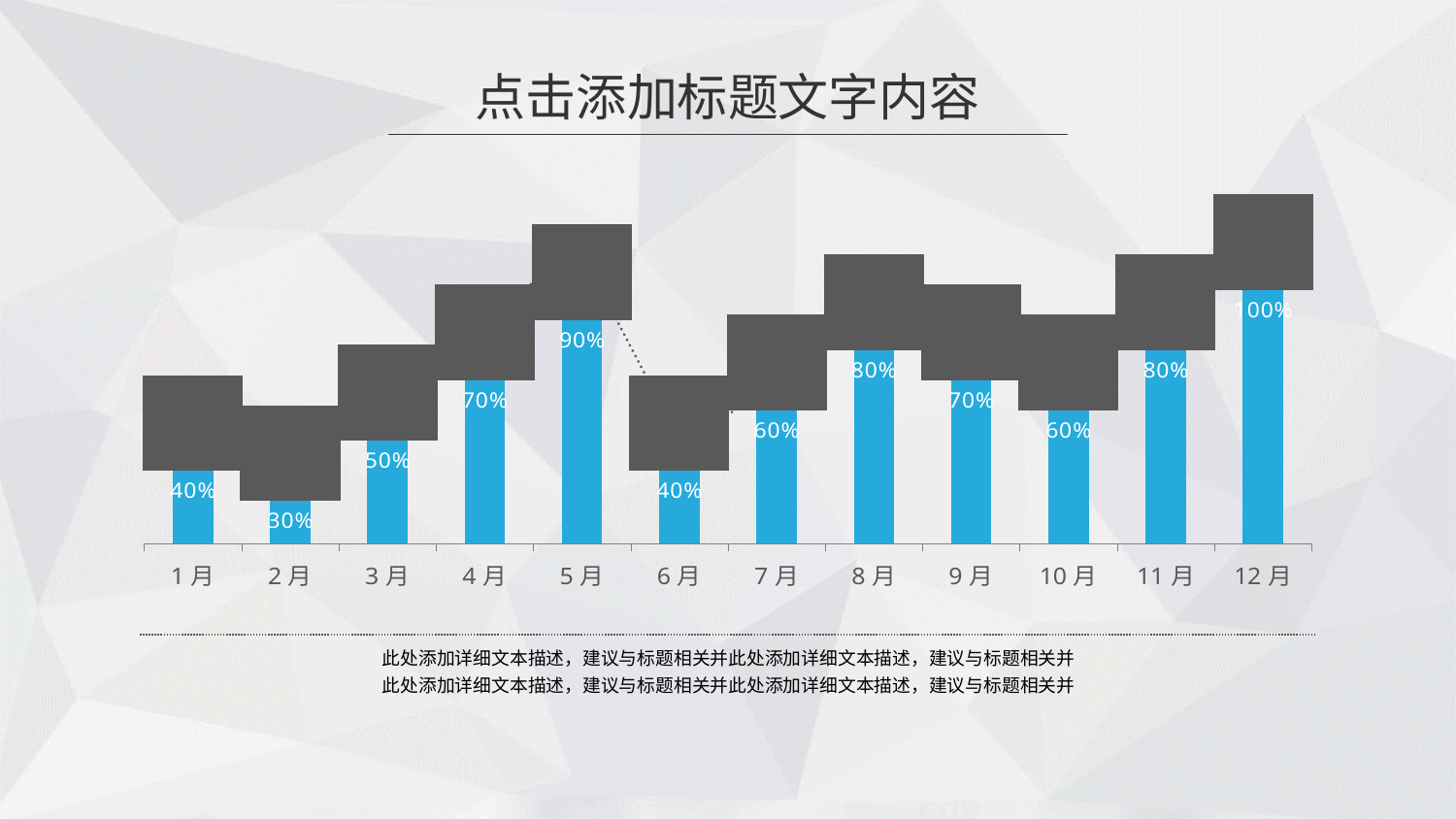
Which is larger, the value for 8月 or the value for 10月? 8月 What is the difference between the values for 12月 and 6月? 60% What is the value for 9月? 70% Do the values rise or fall from 6月 to 8月? rise What is the value for 5月? 90% What is the value for 2月? 30% Which month has the lowest value? 2月 How many months are shown on the x axis? 12 What is the difference between the values for 5月 and 4月? 20% What colour are the bars in the chart? blue Which month has the highest value? 12月 What kind of chart is shown on the slide? bar chart